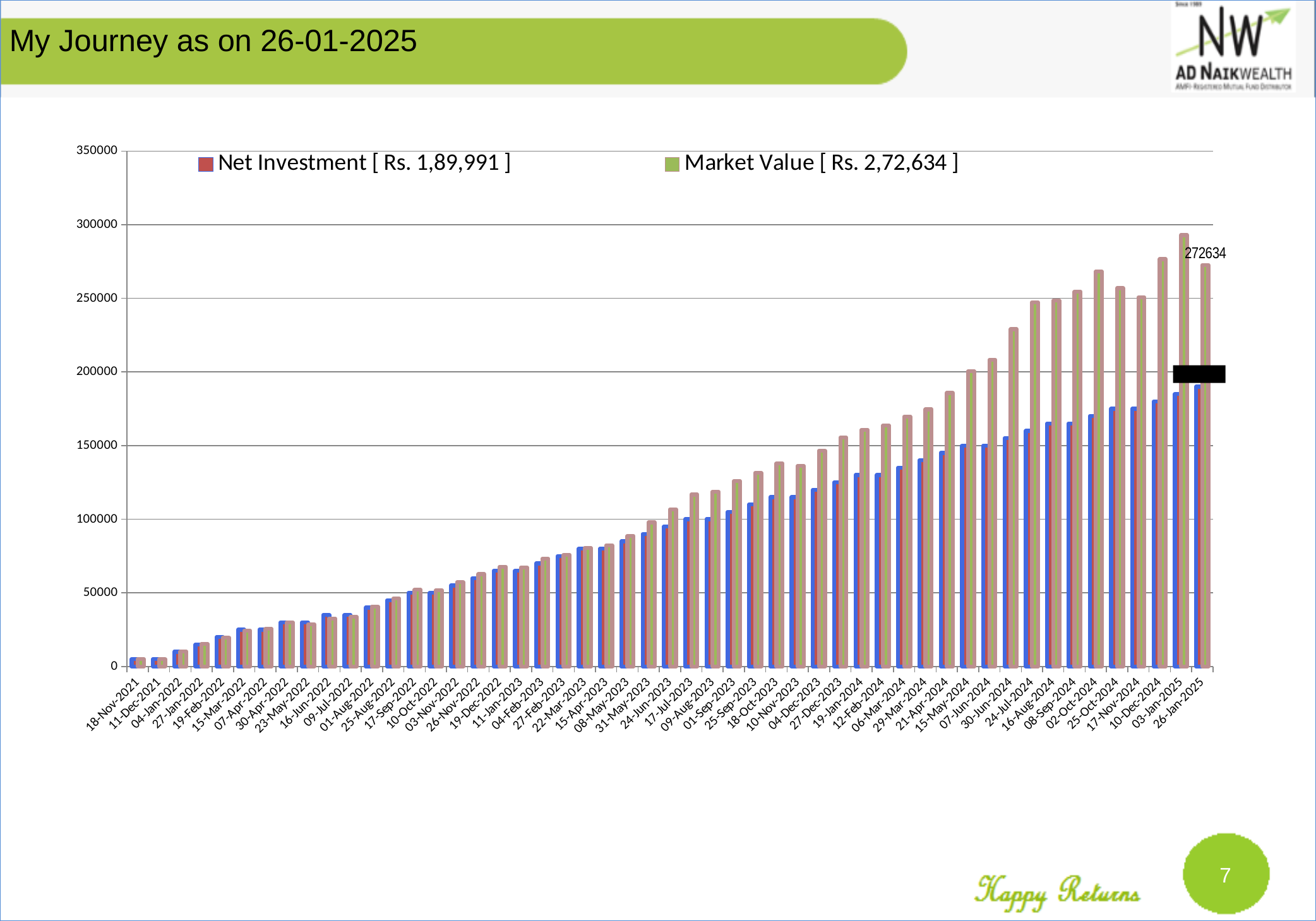
Is the Net Investment on 10-Dec-2024 greater or less than 150000? greater Is the Net Investment on 26-Jan-2025 greater or less than 200000? less On which date is the Market Value highest? 03-Jan-2025 Is the Market Value on 03-Jan-2025 greater or less than 250000? greater What Market Value amount is shown in the legend? Rs. 2,72,634 What is the Market Value on 26-Jan-2025 according to the data label? 272634 On 26-Jan-2025, which is larger: Net Investment or Market Value? Market Value What type of chart is shown on the slide? Bar chart What Net Investment amount is shown in the legend? Rs. 1,89,991 How many series does the legend list? 2 Do the Net Investment values generally rise or fall from 18-Nov-2021 to 26-Jan-2025? rise